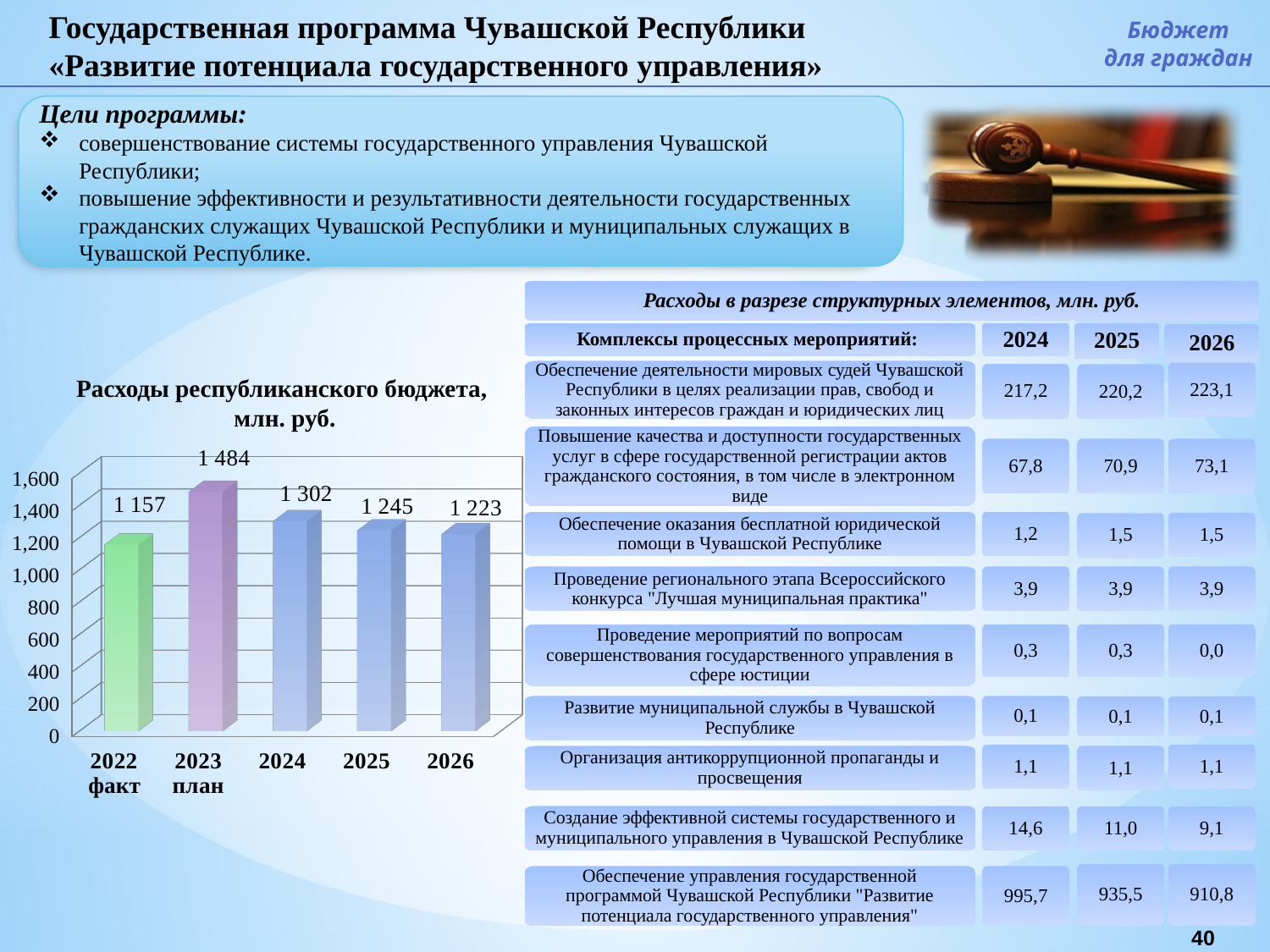
What is the difference between the values for 2023 план and 2022 факт? 327 How many bars are shown in the chart? 5 Which year has the highest value in the chart? 2023 план Is the value for 2025 greater or less than 1,200? greater Which is larger, the value for 2024 or the value for 2025? 2024 Which year has the lowest value in the chart? 2022 факт What is the value for 2023 план in the chart? 1 484 What is the difference between the values for 2024 and 2026? 79 What is the value for 2026 in the chart? 1 223 Do the values rise or fall from 2023 план to 2026? fall What is the value for 2022 факт in the chart «Расходы республиканского бюджета, млн. руб.»? 1 157 What kind of chart is shown on the slide? bar chart